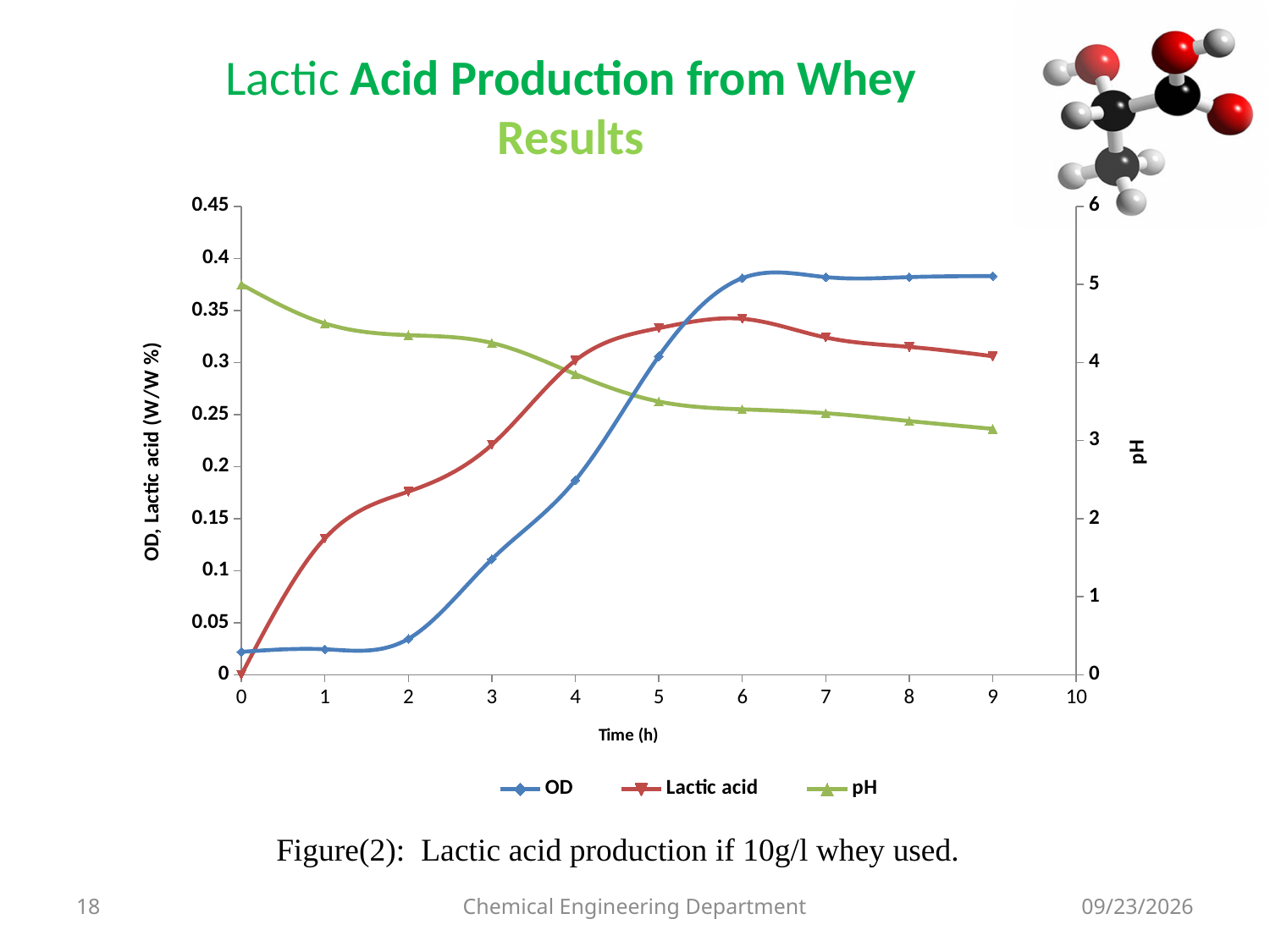
Is the OD value at 2 h greater or less than 0.05? less Does the pH series rise or fall as time increases from 0 to 9 h? fall Is the pH value at 9 h greater or less than 4 on the right axis? less Is the OD value at 9 h greater or less than 0.35? greater At 3 h, which is larger: the OD value or the Lactic acid value? Lactic acid How many series does the legend list? 3 How many data points are plotted for the OD series? 10 What is the title of the x axis? Time (h) What kind of chart is shown on the slide? line chart What is the Lactic acid value at time 0 h? 0